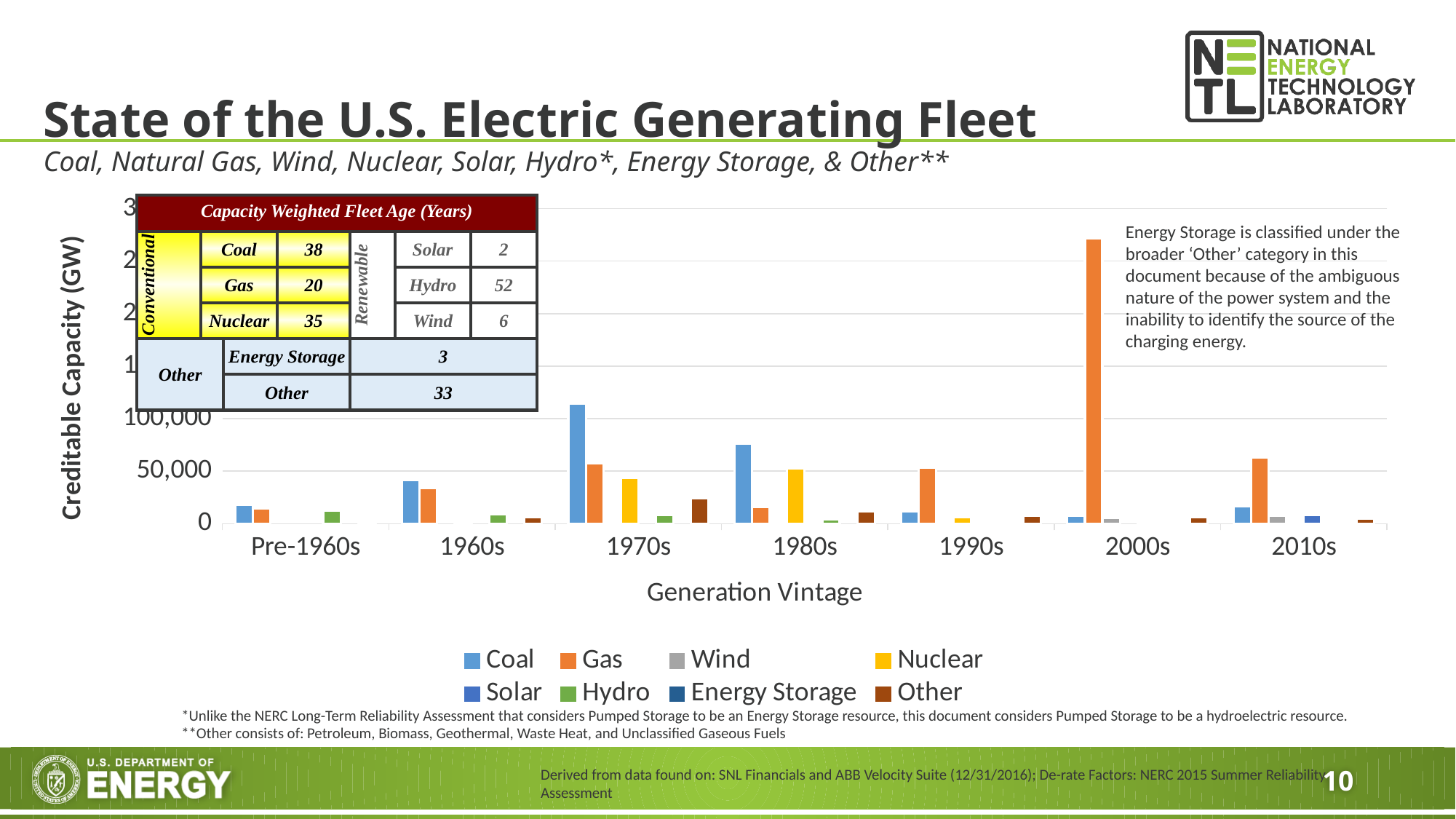
Is the Gas value for the 2000s greater or less than 100,000? greater Is the Coal value for the 1970s greater or less than 100,000? greater What is the title of the x axis? Generation Vintage Is the Nuclear value for the 1970s greater or less than 50,000? less Which series has the tallest bar in the 1980s vintage? Coal How many series does the chart legend list? 8 In the 2010s vintage, which is larger, Coal or Gas? Gas Which series has the tallest bar in the 2000s vintage? Gas Do the Coal values rise or fall from the 1970s to the 2000s? fall In the 1970s vintage, which is larger, Coal or Gas? Coal How many generation vintage categories are shown on the x axis? 7 What kind of chart is shown on the slide? bar chart